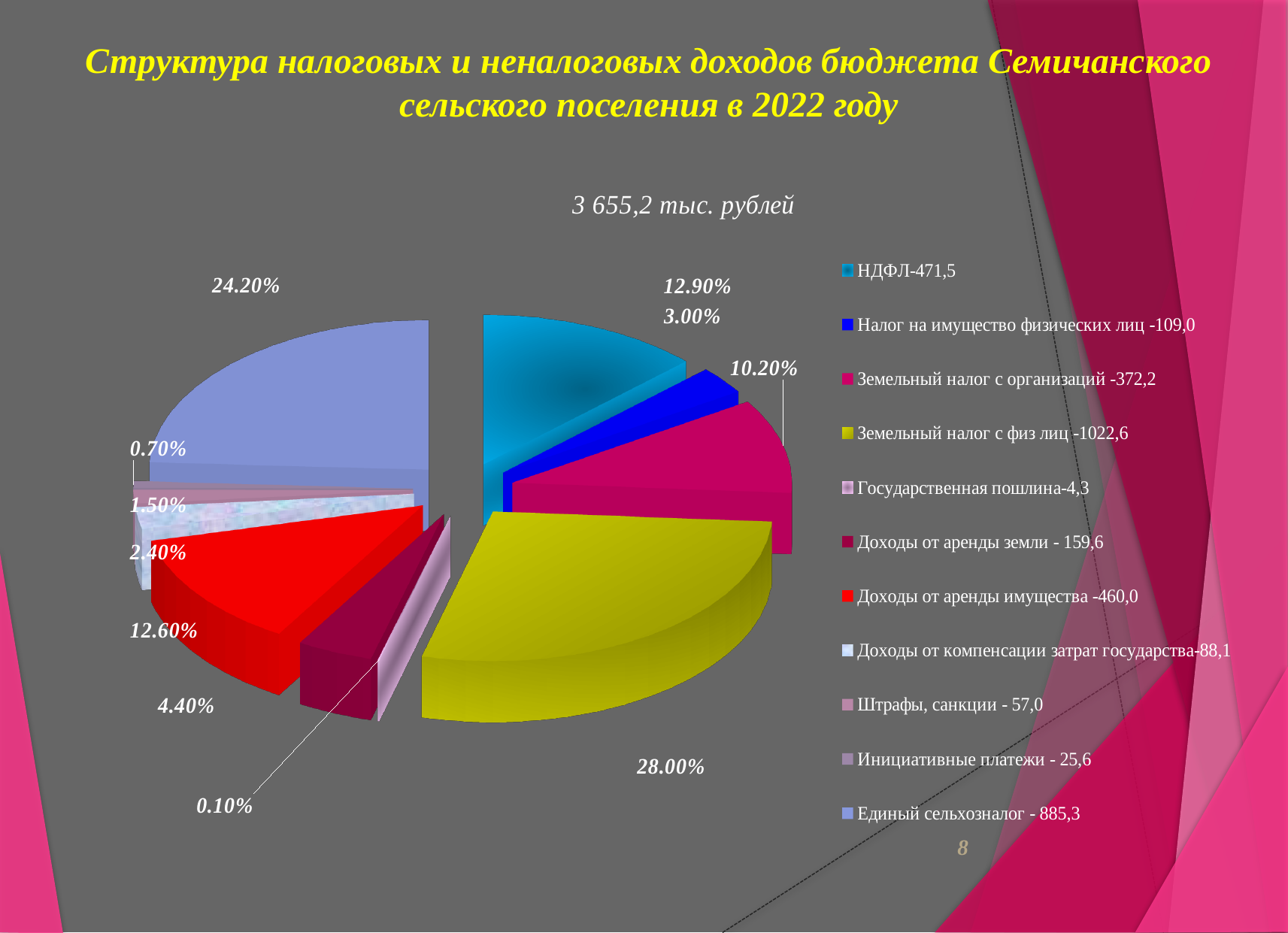
Which is larger: the share for Земельный налог с физ лиц or the share for Единый сельхозналог? Земельный налог с физ лиц What is the difference in percentage points between the share for Земельный налог с физ лиц (28.00%) and the share for Земельный налог с организаций (10.20%)? 17.80% How many categories does the legend of the pie chart list? 11 What value is given in the legend for Штрафы, санкции? 57,0 What value is given in the legend for Земельный налог с организаций? 372,2 What kind of chart is shown on the slide? pie chart Which category has the smallest share of the pie? Государственная пошлина What total amount is shown above the pie chart? 3 655,2 тыс. рублей What share of the pie does НДФЛ have? 12.90% What share of the pie does Доходы от аренды имущества have? 12.60% What share of the pie does Единый сельхозналог have? 24.20% Which category has the largest share of the pie? Земельный налог с физ лиц